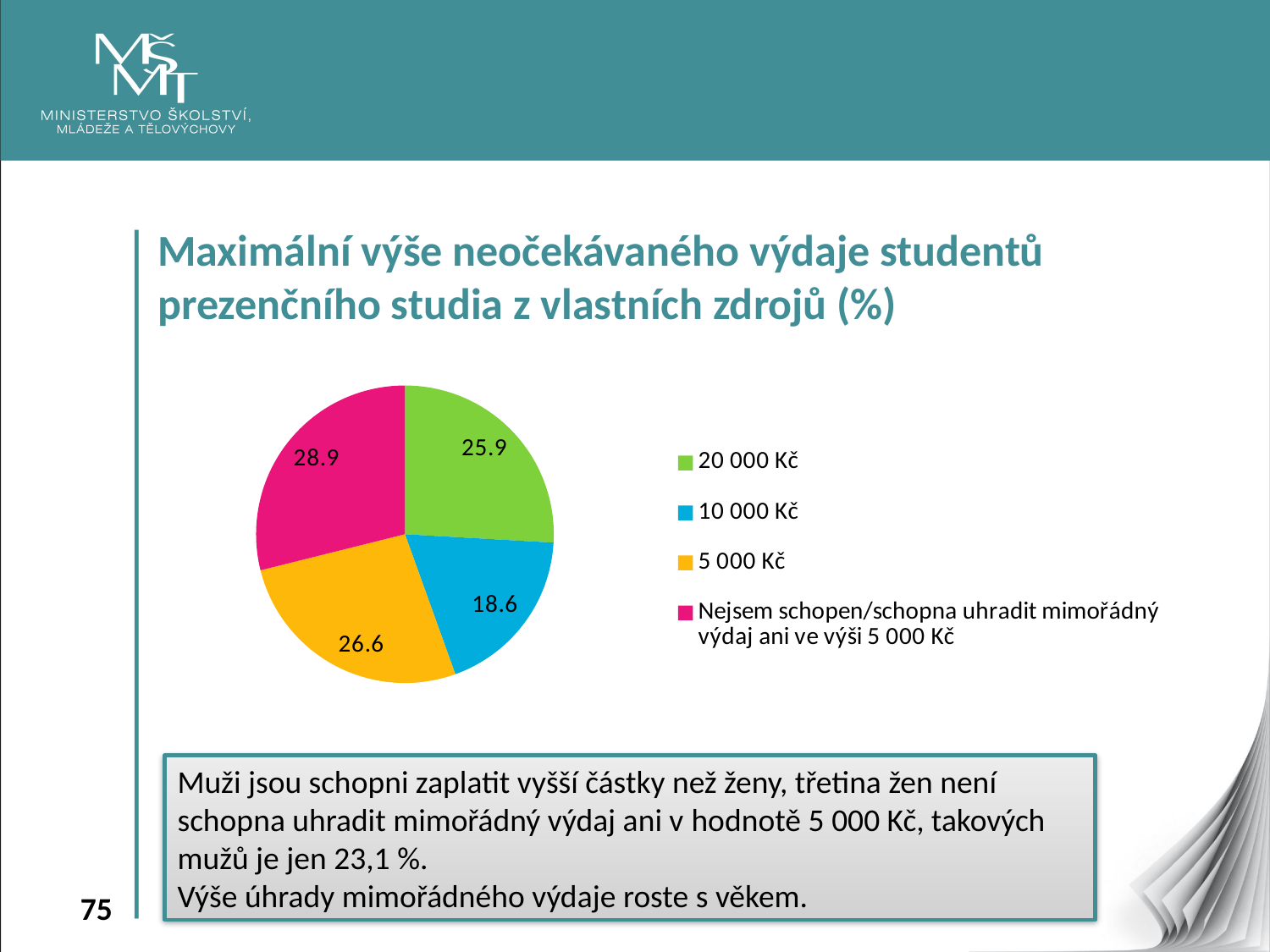
What colour is the slice for "10 000 Kč"? Blue What value is shown for the "5 000 Kč" slice? 26.6 Which category has the smallest slice of the pie? 10 000 Kč What share of students is shown for the "20 000 Kč" slice? 25.9 Which category has the largest slice of the pie? Nejsem schopen/schopna uhradit mimořádný výdaj ani ve výši 5 000 Kč What type of chart is shown on the slide? Pie chart What value is shown for the slice "Nejsem schopen/schopna uhradit mimořádný výdaj ani ve výši 5 000 Kč"? 28.9 What is the difference between the largest slice (28.9) and the smallest slice (18.6)? 10.3 How many slices does the pie chart have? 4 What is the title of the chart on the slide? Maximální výše neočekávaného výdaje studentů prezenčního studia z vlastních zdrojů (%) What value is shown for the "10 000 Kč" slice? 18.6 Which is larger: the slice for "5 000 Kč" or the slice for "20 000 Kč"? 5 000 Kč